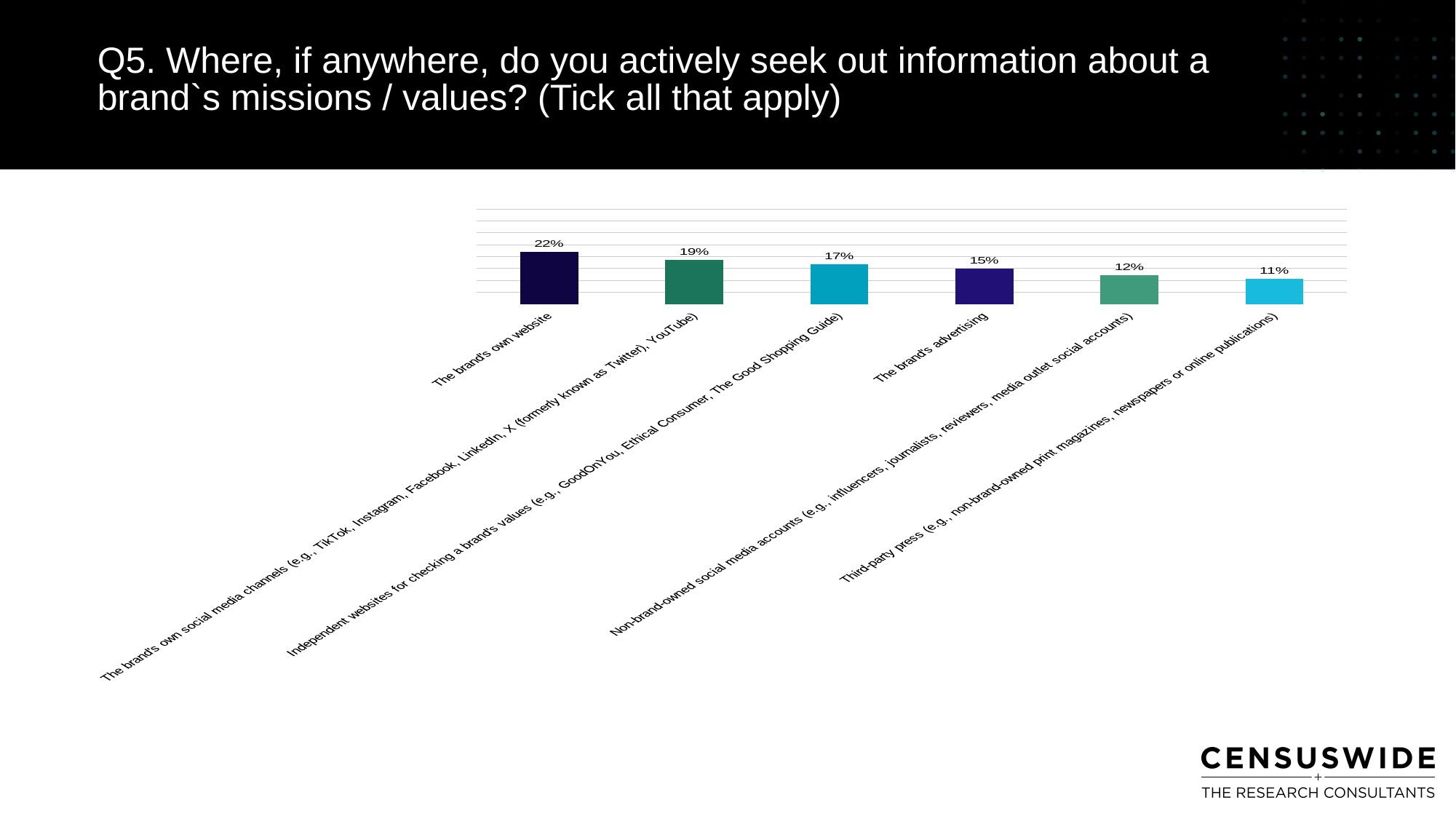
Do the values rise or fall from left to right across the categories? Fall What kind of chart is shown on the slide? Bar chart What is the value for 'The brand's advertising'? 15% What is the difference between the value for the brand's own website and the value for the brand's own social media channels? 3% What is the value for 'Independent websites for checking a brand's values (e.g., GoodOnYou, Ethical Consumer, The Good Shopping Guide)'? 17% How many categories are shown in the chart? 6 Which category has the lowest value? Third-party press (e.g., non-brand-owned print magazines, newspapers or online publications) What percentage of respondents actively seek out information about a brand's missions/values on the brand's own website? 22% Which category has the highest value? The brand's own website Which is larger: the value for 'The brand's advertising' or the value for 'Non-brand-owned social media accounts'? The brand's advertising What is the value for 'Third-party press (e.g., non-brand-owned print magazines, newspapers or online publications)'? 11% What is the difference between the value for 'Non-brand-owned social media accounts' and the value for 'Third-party press'? 1%